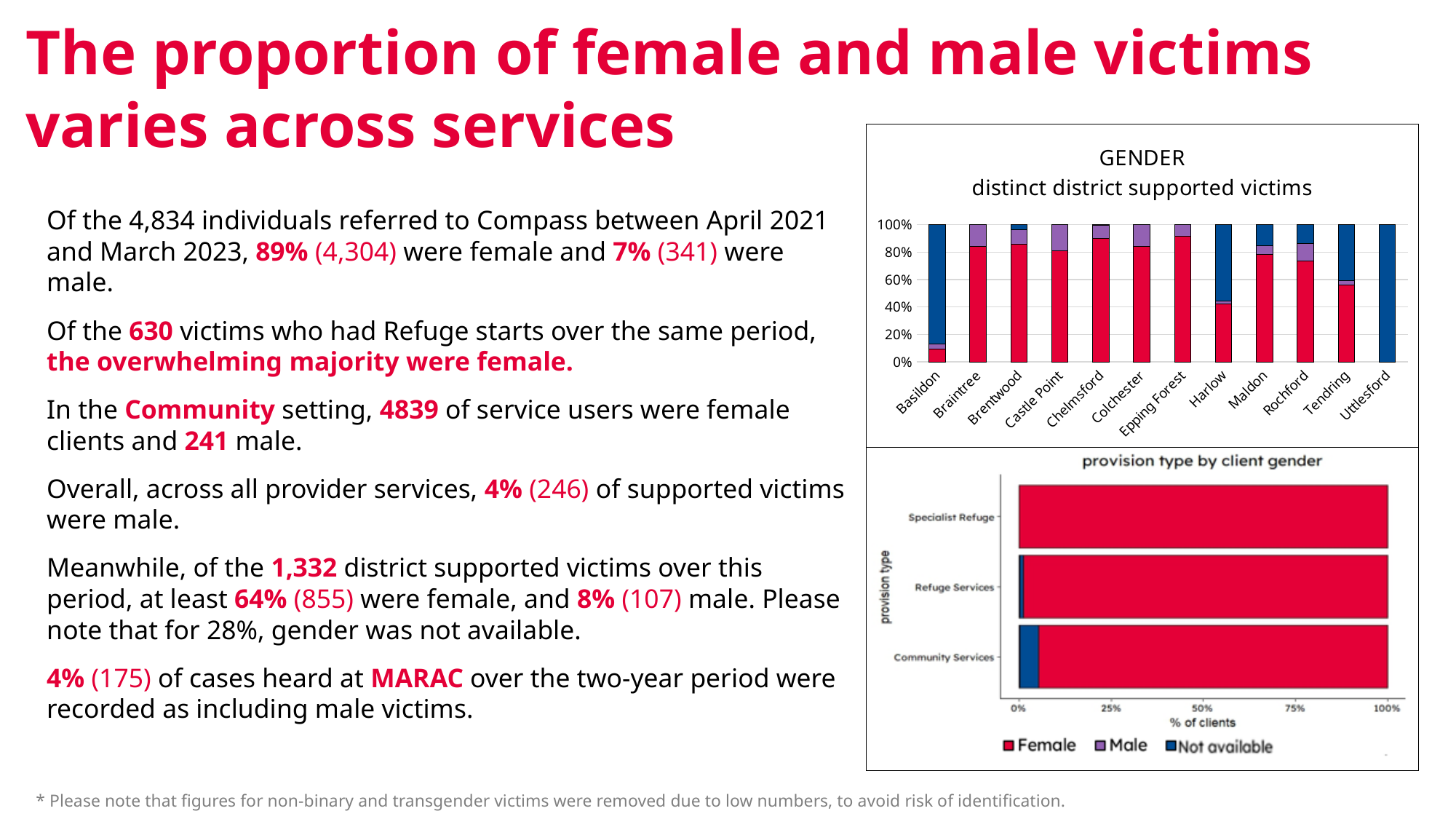
In the top chart 'GENDER distinct district supported victims', which district has the lowest Female share? Uttlesford In the top chart 'GENDER distinct district supported victims', is the Female share for Tendring greater or less than 40%? greater In the top chart 'GENDER distinct district supported victims', how many districts are shown on the x axis? 12 How many series does the legend list for the gender charts? 3 What kind of chart is the top chart titled 'GENDER distinct district supported victims'? Stacked bar chart In the bottom chart 'provision type by client gender', how many provision types are shown? 3 What kind of chart is the bottom chart titled 'provision type by client gender'? Stacked bar chart In the top chart 'GENDER distinct district supported victims', which district has the largest 'Not available' share? Uttlesford In the bottom chart 'provision type by client gender', which provision type has the largest 'Not available' share? Community Services In the top chart 'GENDER distinct district supported victims', is the Female share for Harlow greater or less than 60%? less In the top chart 'GENDER distinct district supported victims', is the Female share for Basildon greater or less than 20%? less In the top chart 'GENDER distinct district supported victims', which has the larger Female share, Braintree or Harlow? Braintree